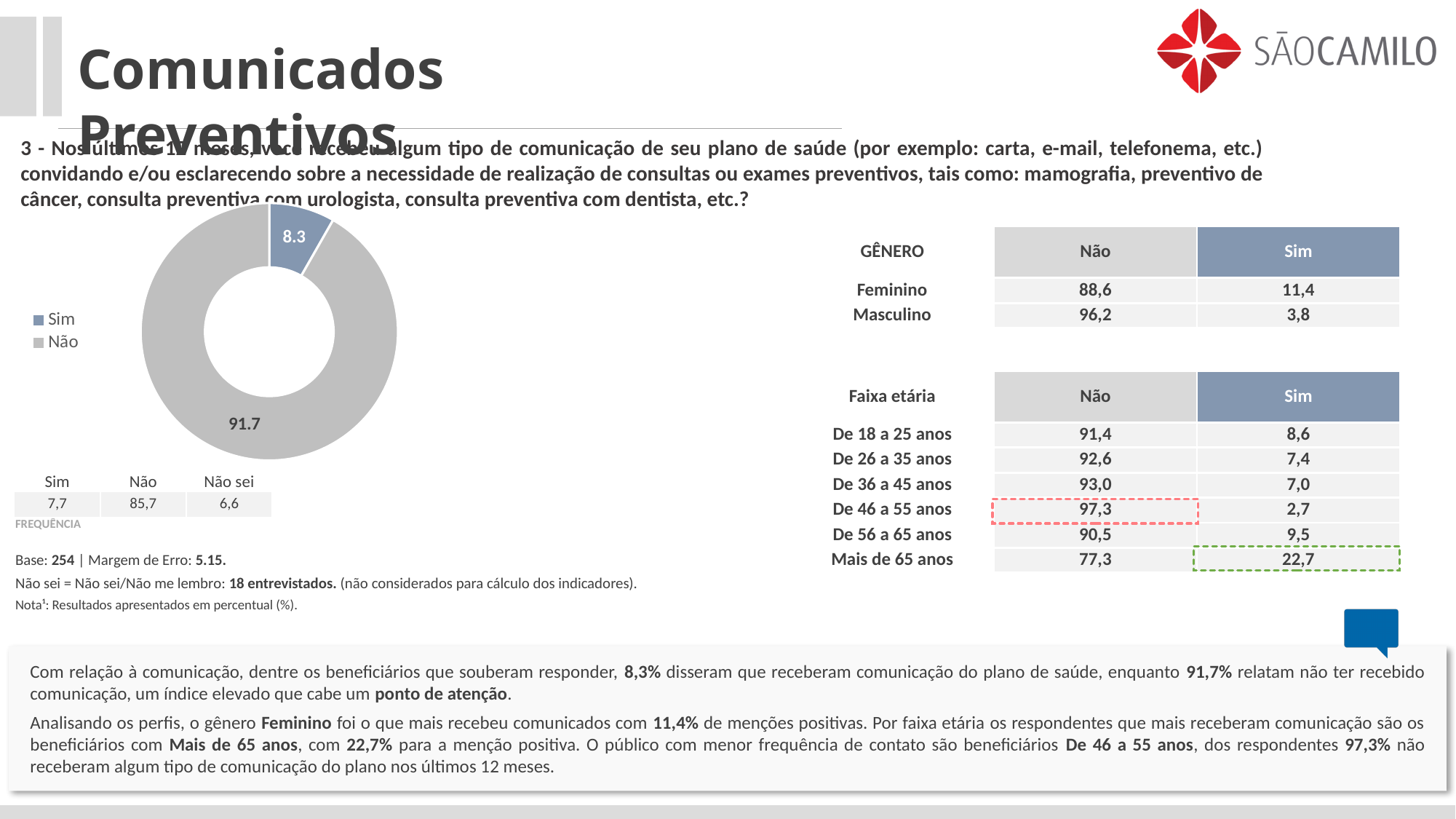
In the donut chart, what is the difference between the 'Não' value and the 'Sim' value? 83.4 Which slice of the donut chart is the smallest? Sim In the donut chart, which is larger: 'Sim' or 'Não'? Não What colour is used for the 'Não' slice in the donut chart? Grey How many entries does the legend of the donut chart list? 2 What kind of chart is shown on the left of the slide? Donut (pie) chart What share of the donut chart does the 'Não' slice represent? 91.7 In the donut chart, what value is shown for the 'Não' slice? 91.7 How many slices does the donut chart have? 2 Which slice of the donut chart is the largest? Não In the donut chart, what value is shown for the 'Sim' slice? 8.3 What colour is used for the 'Sim' slice in the donut chart? Blue